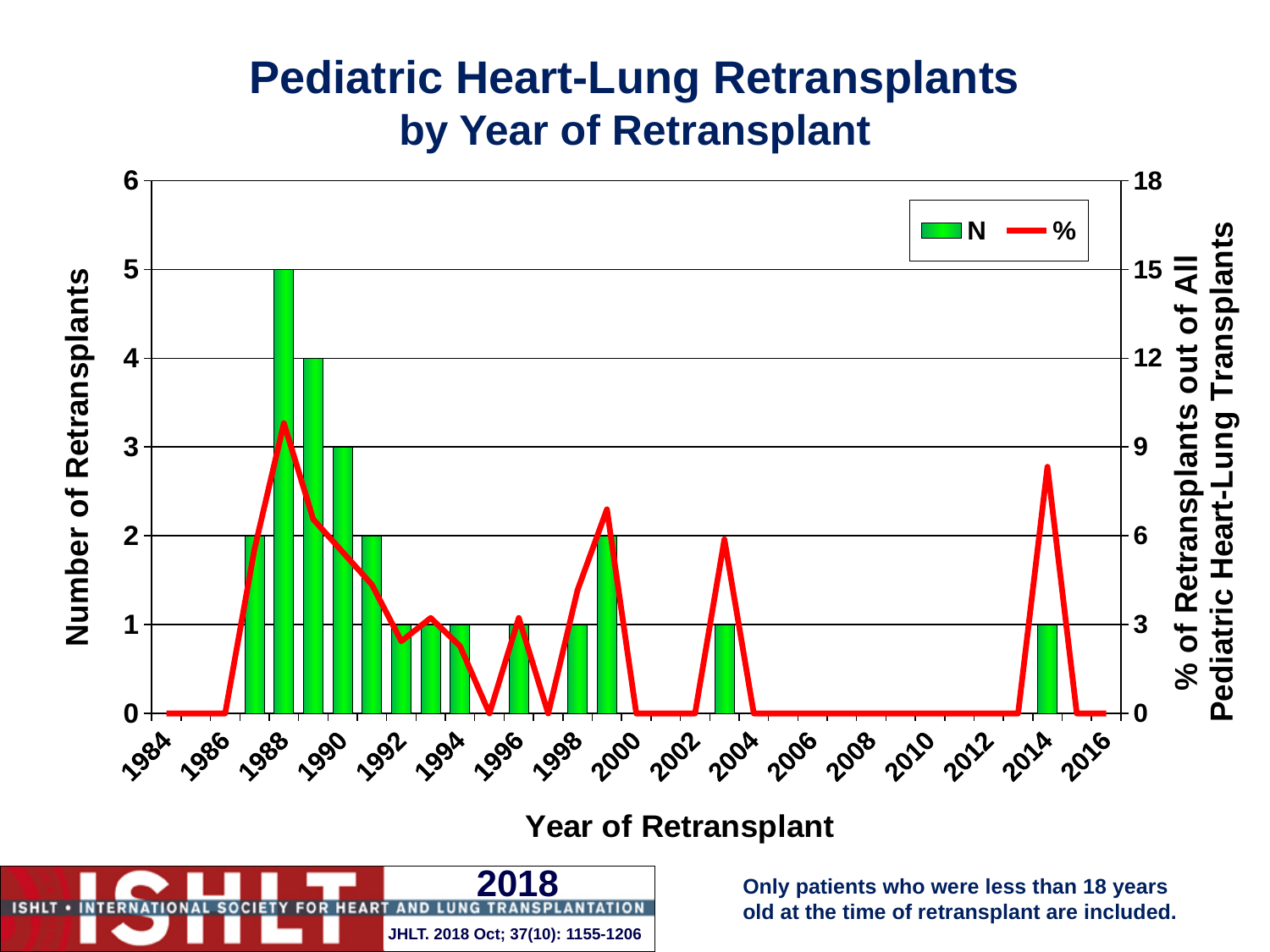
What is the number of retransplants in 1988? 5 Does the number of retransplants rise or fall from 1988 to 1992? fall Is the % of retransplants value for 1988 greater or less than 9? greater What is the number of retransplants in 2014? 1 Is the % of retransplants value for 2014 greater or less than 9? less How many series does the legend list? 2 Which year has the highest number of retransplants? 1988 Which year has more retransplants, 1987 or 1992? 1987 What is the number of retransplants in 1989? 4 What is the difference in the number of retransplants between 1988 and 1990? 2 What is the number of retransplants in 1990? 3 What kind of chart is shown on the slide? A bar chart with a line series